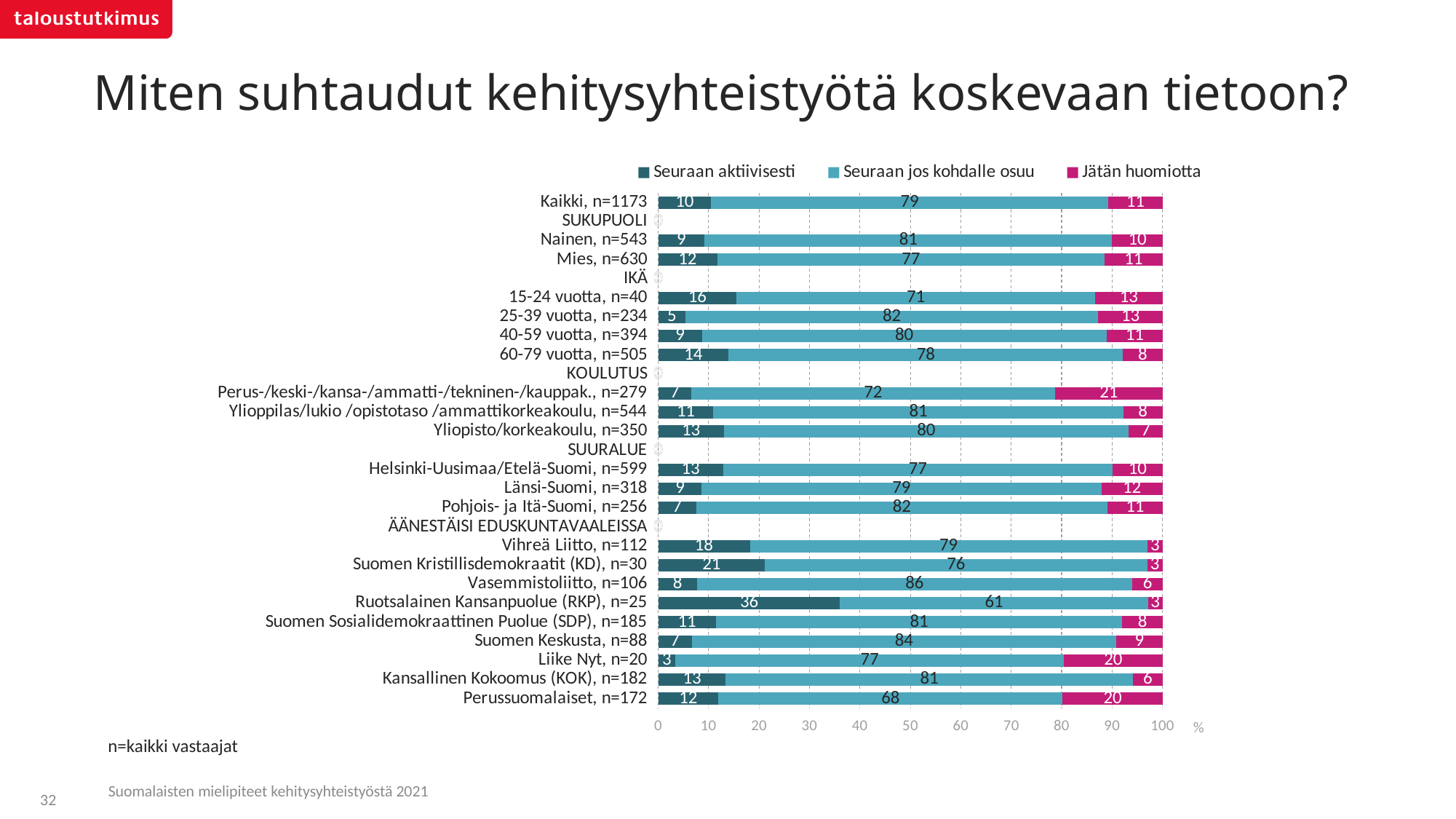
What is the value of "Seuraan aktiivisesti" for Ruotsalainen Kansanpuolue (RKP), n=25? 36 Which category has the highest value for "Seuraan aktiivisesti"? Ruotsalainen Kansanpuolue (RKP), n=25 Which category has the lowest value for "Seuraan aktiivisesti"? Liike Nyt, n=20 What is the value of "Seuraan jos kohdalle osuu" for Kaikki, n=1173? 79 What kind of chart is shown on the slide? Stacked bar chart How many series does the legend list? 3 Which category has the highest value for "Jätän huomiotta"? Perus-/keski-/kansa-/ammatti-/tekninen-/kauppak., n=279 Which has the larger "Seuraan aktiivisesti" value, Nainen, n=543 or Mies, n=630? Mies, n=630 What is the difference between the "Jätän huomiotta" value for Liike Nyt, n=20 and for Kaikki, n=1173? 9 What is the total of the stacked bar for 15-24 vuotta, n=40? 100 What is the value of "Jätän huomiotta" for Perussuomalaiset, n=172? 20 Which category has the highest value for "Seuraan jos kohdalle osuu"? Vasemmistoliitto, n=106